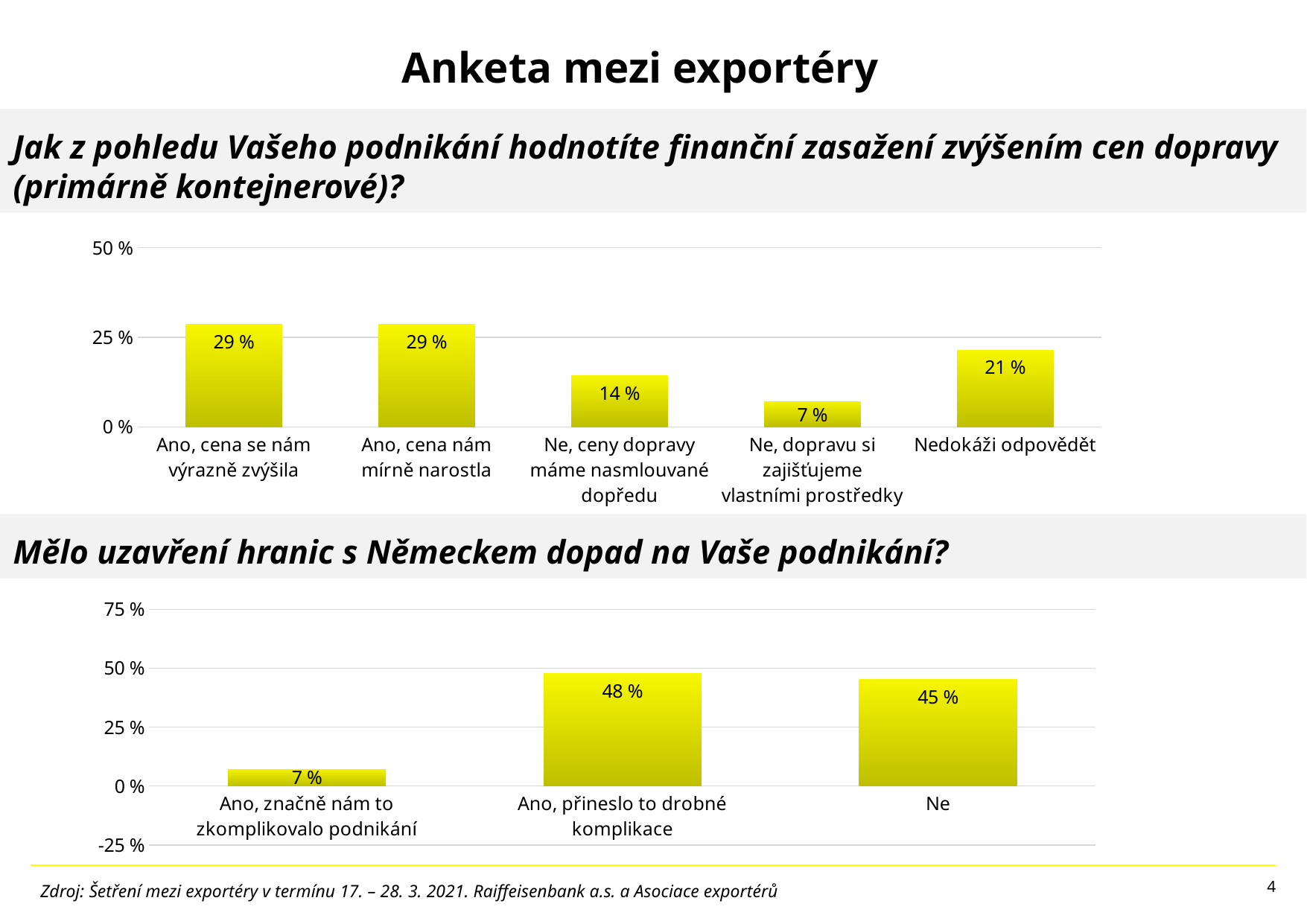
In the top chart, what is the value for "Ne, ceny dopravy máme nasmlouvané dopředu"? 14 % What type of chart is the bottom chart? bar chart In the bottom chart, what is the value for "Ne"? 45 % In the top chart, what is the value for "Nedokáži odpovědět"? 21 % In the top chart, how many categories are shown? 5 In the bottom chart, how many categories are shown? 3 In the bottom chart, which category has the highest value? Ano, přineslo to drobné komplikace In the top chart, is the value for "Ano, cena nám mírně narostla" greater or less than 25 %? greater In the bottom chart, which category has the lowest value? Ano, značně nám to zkomplikovalo podnikání In the bottom chart, what is the difference between "Ano, přineslo to drobné komplikace" and "Ne"? 3 % In the top chart, what is the difference between "Ano, cena se nám výrazně zvýšila" and "Nedokáži odpovědět"? 8 % In the top chart, which category has the lowest value? Ne, dopravu si zajišťujeme vlastními prostředky